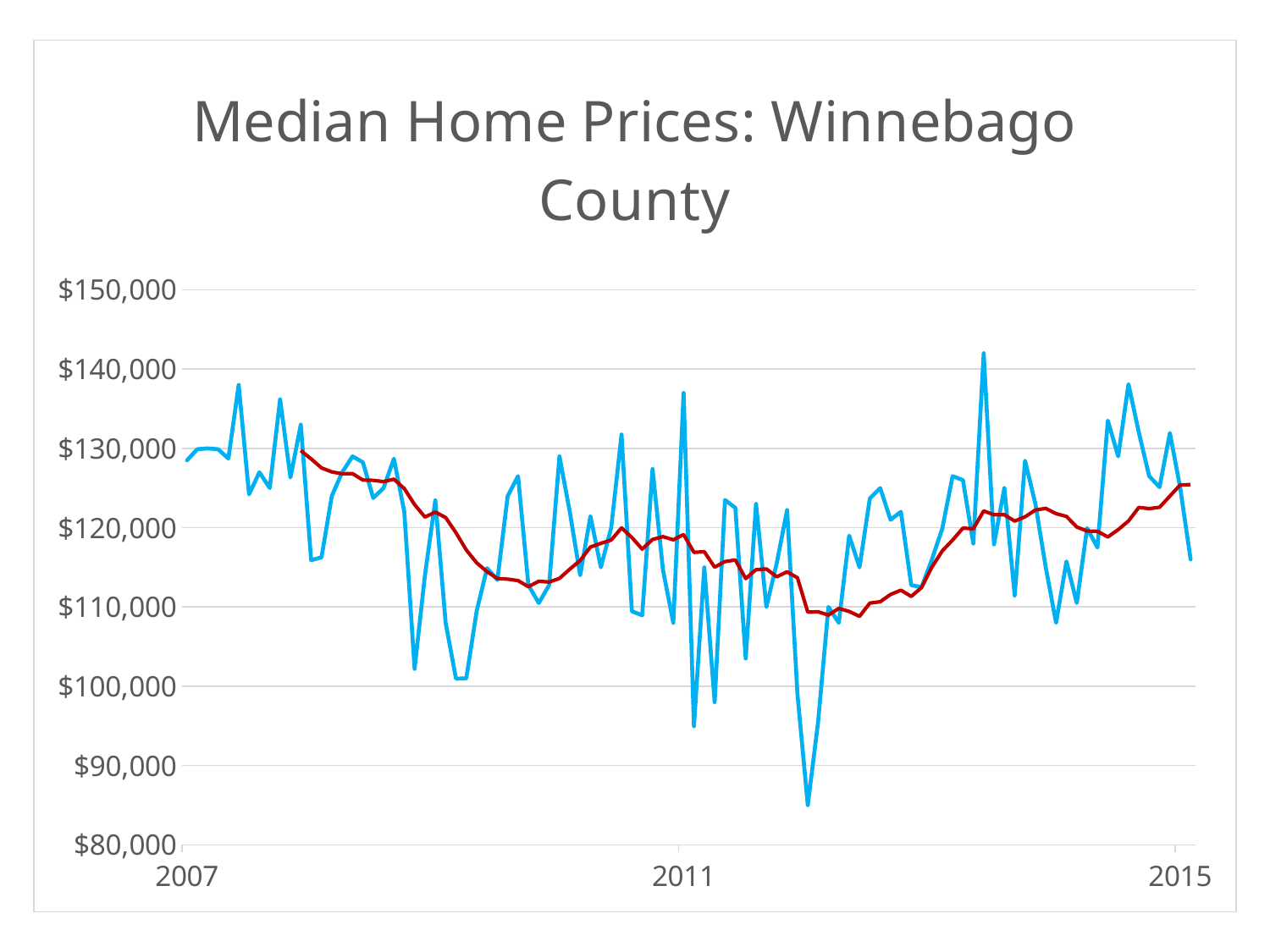
How many lines are plotted on the chart? 2 What is the title of the chart? Median Home Prices: Winnebago County Is the highest point of the blue line greater or less than $140,000? greater Does the red line rise or fall between 2008 and 2010? fall Is the lowest point of the red line greater or less than $100,000? greater Which year labels are shown on the x axis? 2007, 2011, 2015 Does the red line rise or fall between 2011 and 2015? rise What type of chart is shown on the slide? line chart Is the value of the red line at 2015 greater or less than $120,000? greater